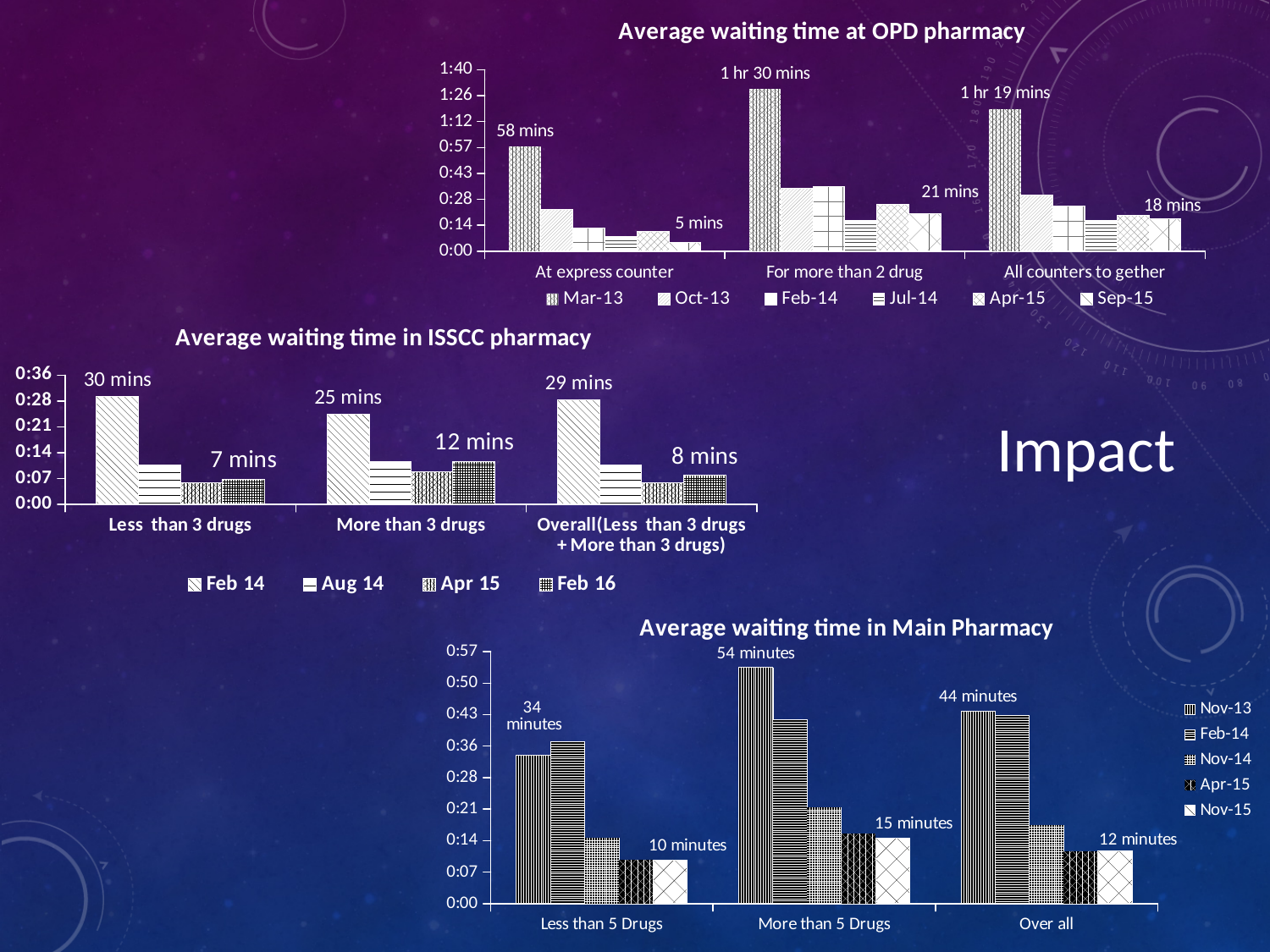
In the 'Average waiting time in Main Pharmacy' chart, which category has the lowest Nov-15 value? Less than 5 Drugs In the 'Average waiting time in ISSCC pharmacy' chart, what is the Feb 14 value for 'More than 3 drugs'? 25 mins What type of chart is 'Average waiting time in Main Pharmacy'? bar chart In the 'Average waiting time in ISSCC pharmacy' chart, which is larger: the Feb 16 value for 'More than 3 drugs' or the Feb 16 value for 'Overall(Less than 3 drugs + More than 3 drugs)'? More than 3 drugs In the 'Average waiting time at OPD pharmacy' chart, what is the Sep-15 value for 'All counters to gether'? 18 mins In the 'Average waiting time in Main Pharmacy' chart, is the Feb-14 value for 'Less than 5 Drugs' greater or less than 0:28? greater In the 'Average waiting time at OPD pharmacy' chart, what is the Mar-13 value for 'At express counter'? 58 mins In the 'Average waiting time in Main Pharmacy' chart, what is the Nov-13 value for 'More than 5 Drugs'? 54 minutes In the 'Average waiting time at OPD pharmacy' chart, which category has the highest Mar-13 value? For more than 2 drug In the 'Average waiting time in ISSCC pharmacy' chart, what is the difference between the Feb 14 and Feb 16 values for 'Less than 3 drugs'? 23 mins In the 'Average waiting time in ISSCC pharmacy' chart, how many categories are shown on the x axis? 3 In the 'Average waiting time at OPD pharmacy' chart, how many series does the legend list? 6